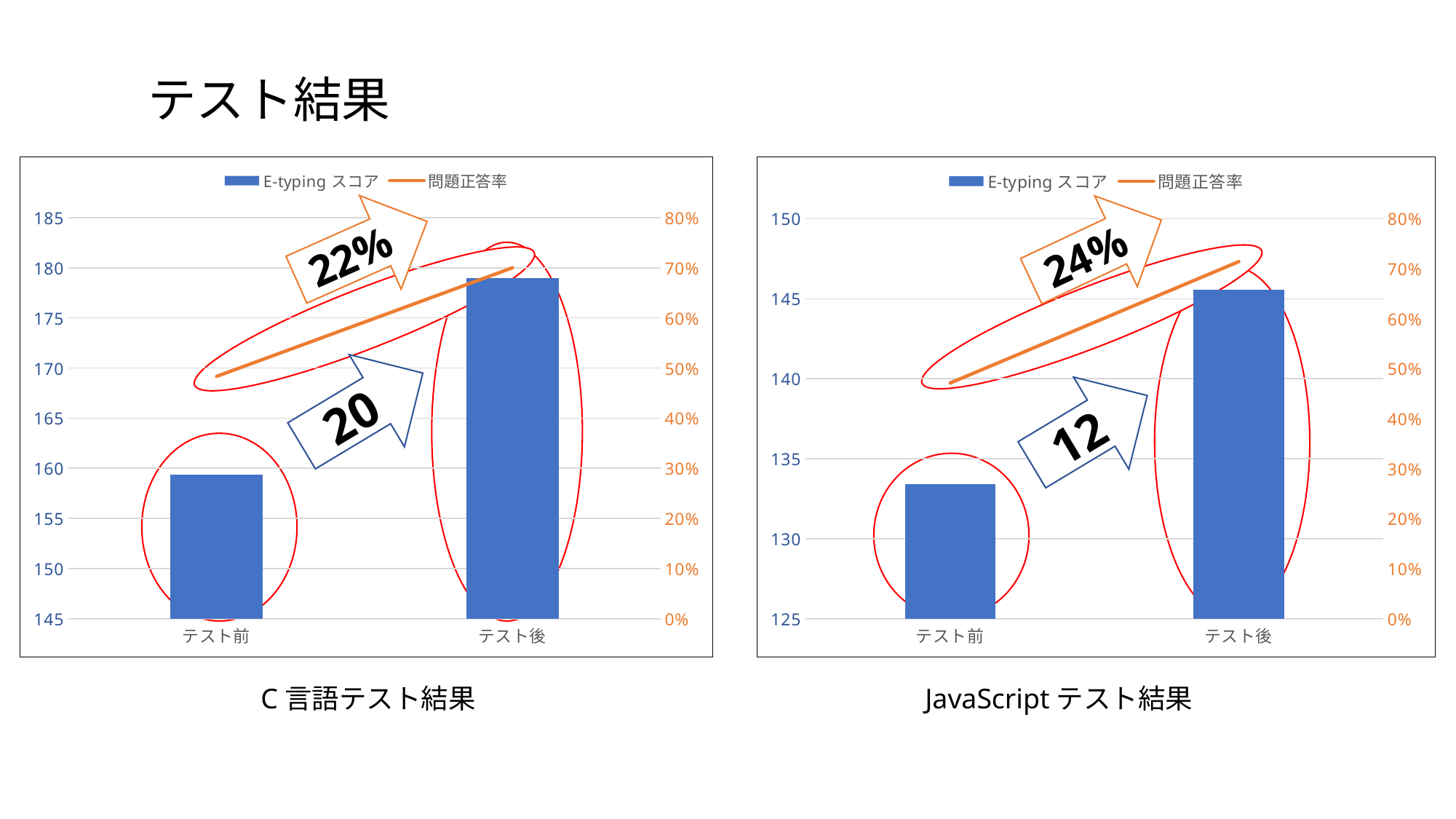
In the JavaScript テスト結果 chart, what increase in E-typing スコア is annotated on the arrow? 12 In the JavaScript テスト結果 chart, is the E-typing スコア for テスト前 greater or less than 135? less In the C 言語テスト結果 chart, what increase in 問題正答率 is annotated on the arrow? 22% In the JavaScript テスト結果 chart, how many categories are shown on the x axis? 2 In the JavaScript テスト結果 chart, does the 問題正答率 line rise or fall from テスト前 to テスト後? rise In the C 言語テスト結果 chart, is the 問題正答率 for テスト後 greater or less than 60%? greater In the JavaScript テスト結果 chart, is the E-typing スコア for テスト後 greater or less than 140? greater In the JavaScript テスト結果 chart, which category has the lower E-typing スコア bar? テスト前 In the C 言語テスト結果 chart, how many series does the legend list? 2 In the C 言語テスト結果 chart, which category has the higher E-typing スコア bar, テスト前 or テスト後? テスト後